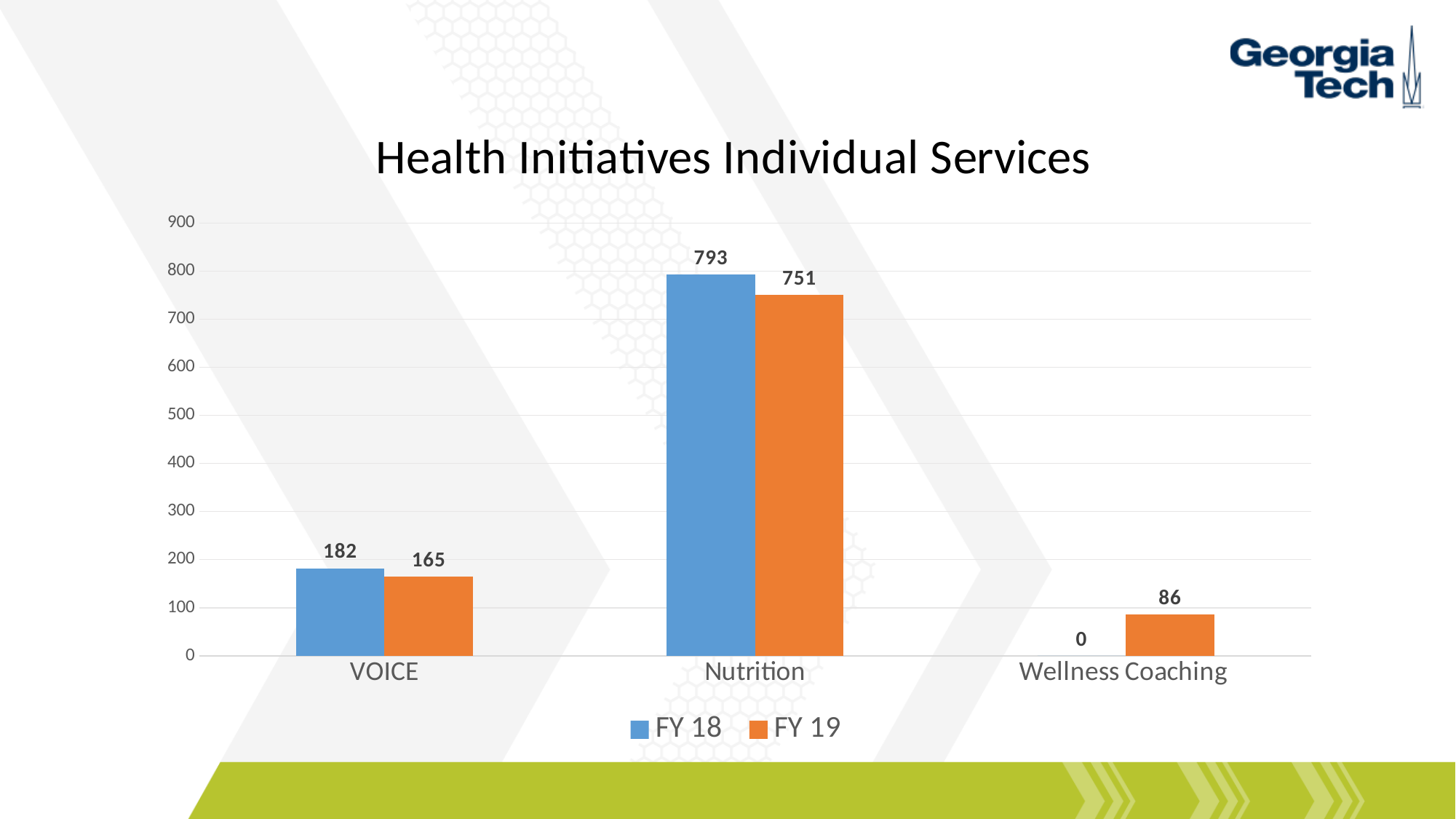
What is the FY 19 value for VOICE? 165 Which is larger for VOICE, the FY 18 value or the FY 19 value? FY 18 How many series does the legend list? 2 What is the difference between the FY 18 and FY 19 values for Nutrition? 42 Which category has the lowest FY 18 value? Wellness Coaching What is the difference between the FY 18 and FY 19 values for VOICE? 17 How many categories are shown on the x axis? 3 What is the FY 18 value for Wellness Coaching? 0 What kind of chart is shown on the slide? Bar chart What is the FY 18 value for Nutrition? 793 What is the FY 19 value for Wellness Coaching? 86 Which category has the highest FY 19 value? Nutrition